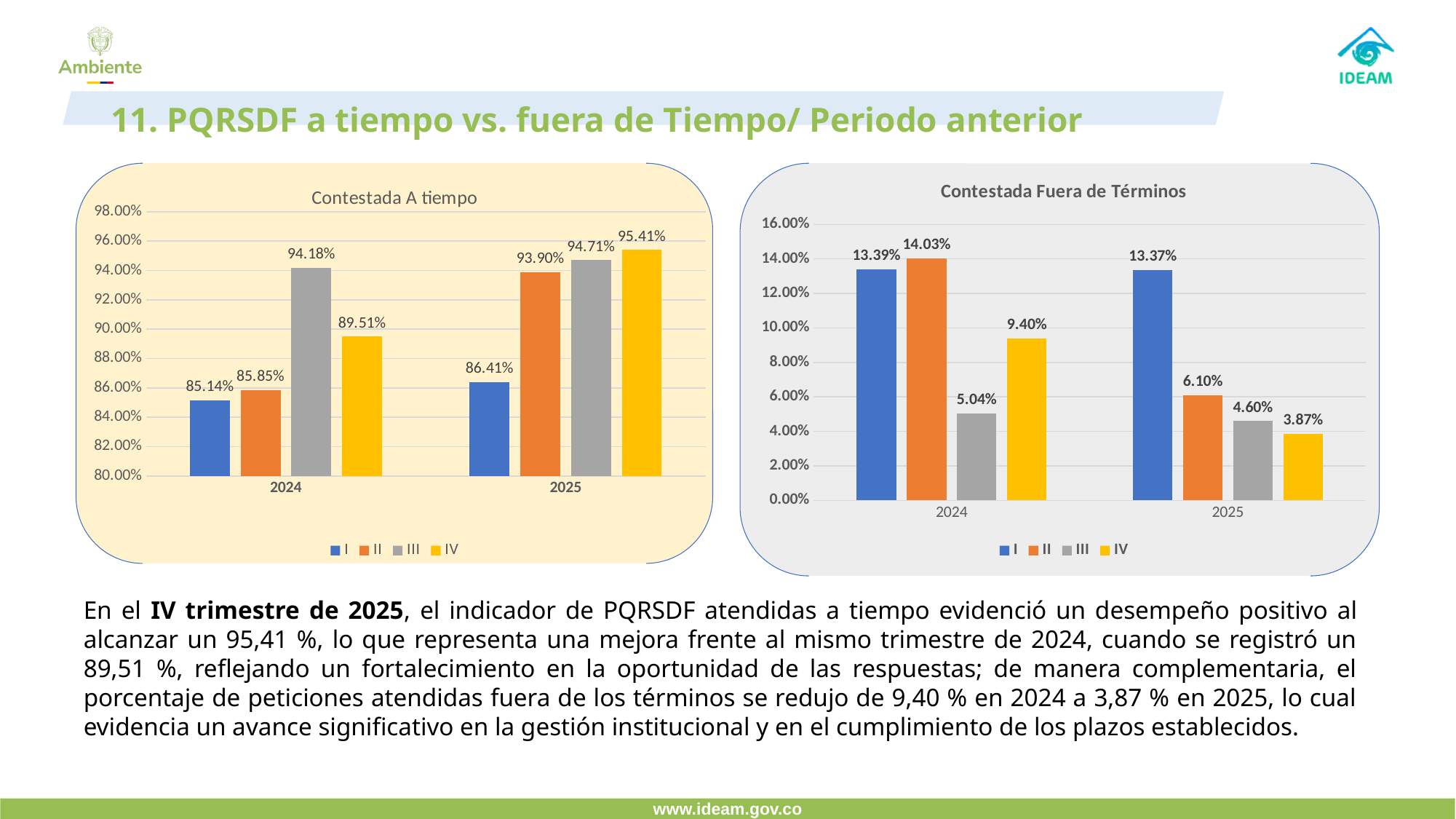
In the 'Contestada Fuera de Términos' chart, is the value for series III in 2024 greater or less than 6.00%? less In the 'Contestada Fuera de Términos' chart, what is the difference between the series IV values for 2024 and 2025? 5.53% How many series does the legend of the 'Contestada Fuera de Términos' chart list? 4 In the 'Contestada Fuera de Términos' chart, what is the value for series IV in 2025? 3.87% In the 'Contestada Fuera de Términos' chart, what is the value for series II in 2024? 14.03% In the 'Contestada A tiempo' chart, what is the value for series I in 2024? 85.14% What kind of chart is the 'Contestada A tiempo' chart? Bar chart In the 'Contestada A tiempo' chart, what is the difference between the series IV values for 2025 and 2024? 5.90% In the 'Contestada A tiempo' chart, which is larger: series III in 2024 or series II in 2025? Series III in 2024 In the 'Contestada A tiempo' chart, which series has the lowest value in 2024? I In the 'Contestada A tiempo' chart, what is the value for series IV in 2025? 95.41% In the 'Contestada Fuera de Términos' chart, which series has the highest value in 2024? II